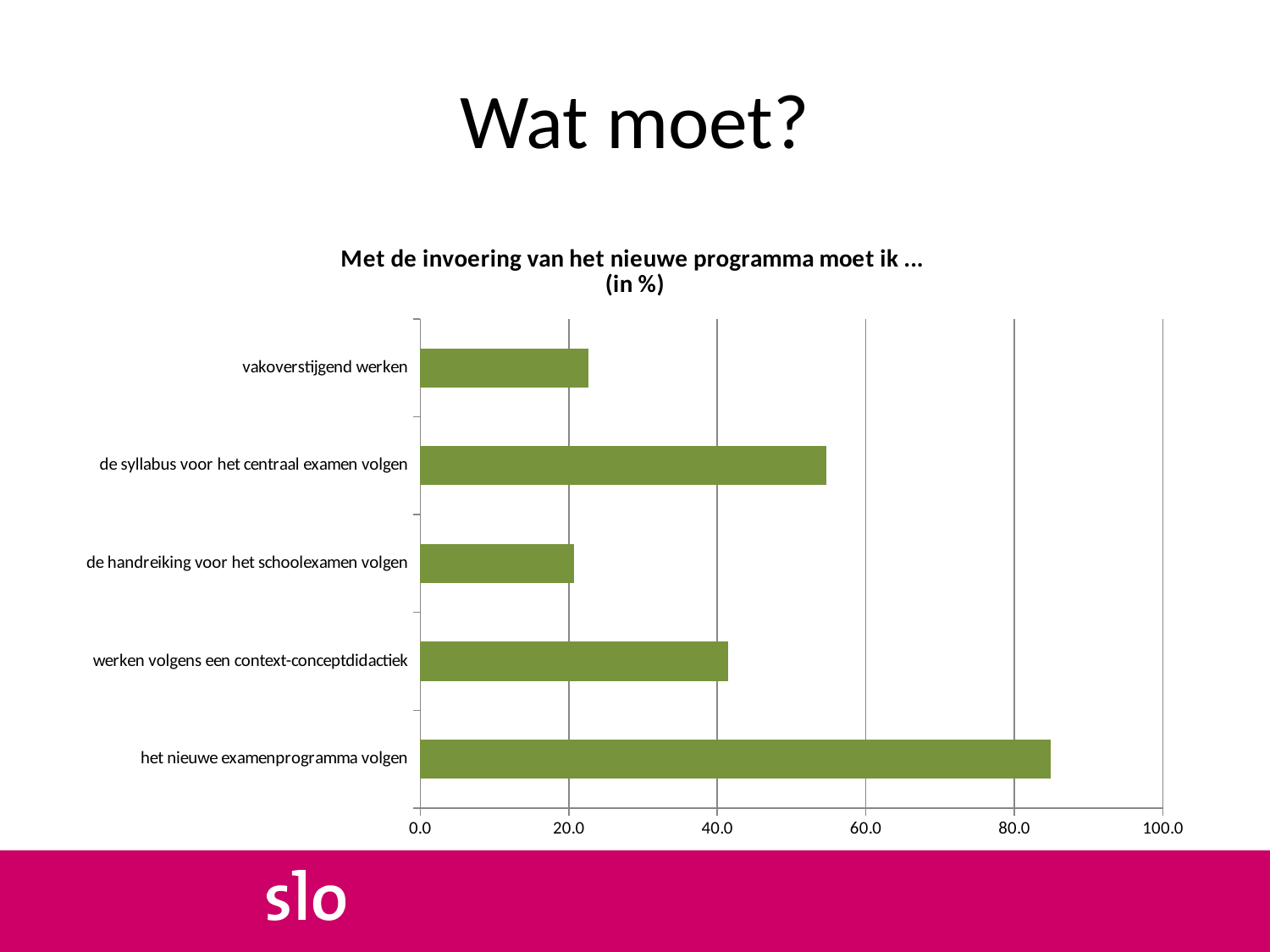
Is the value for 'het nieuwe examenprogramma volgen' greater or less than 80? greater How many categories are plotted in the chart? 5 Which is larger: the value for 'het nieuwe examenprogramma volgen' or for 'vakoverstijgend werken'? het nieuwe examenprogramma volgen Which category has the highest value in the chart? het nieuwe examenprogramma volgen What is the title of the chart? Met de invoering van het nieuwe programma moet ik … (in %) Which is larger: the value for 'de syllabus voor het centraal examen volgen' or for 'werken volgens een context-conceptdidactiek'? de syllabus voor het centraal examen volgen Is the value for 'de syllabus voor het centraal examen volgen' greater or less than 40? greater Is the value for 'de syllabus voor het centraal examen volgen' greater or less than 60? less What kind of chart is shown on the slide? bar chart